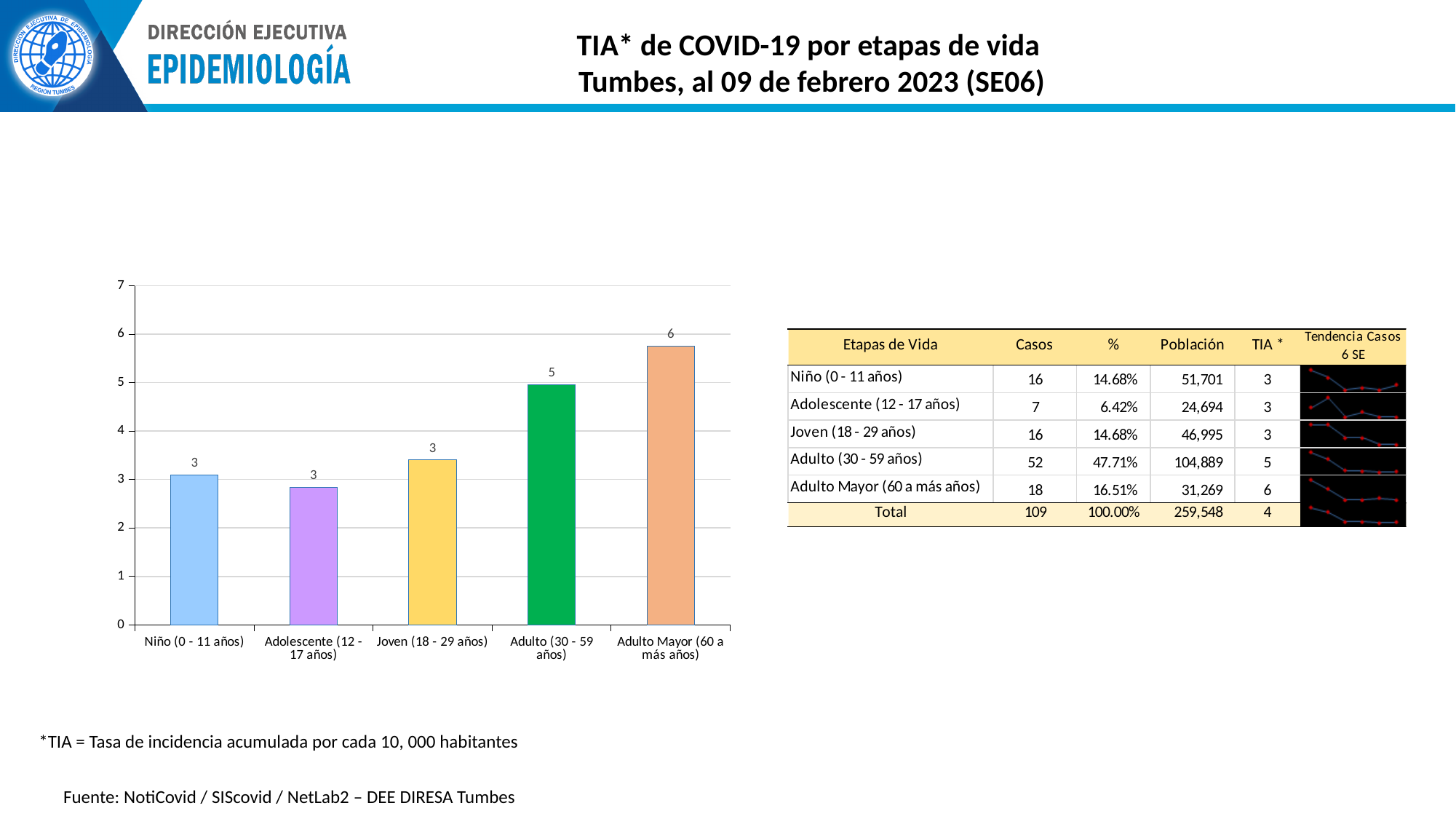
Which has a larger TIA in the bar chart, Adulto (30 - 59 años) or Joven (18 - 29 años)? Adulto (30 - 59 años) What kind of chart is used to show the TIA by life stage? bar chart What colour is the bar for Adulto (30 - 59 años)? green What is the TIA value shown for Niño (0 - 11 años) in the bar chart? 3 Do the TIA values generally rise or fall from Niño to Adulto Mayor along the x axis? rise Is the bar for Adulto Mayor (60 a más años) greater or less than 5? greater What is the difference between the TIA labels for Adulto Mayor (60 a más años) and Adulto (30 - 59 años)? 1 Is the bar for Niño (0 - 11 años) greater or less than 4? less Which life stage has the highest TIA in the bar chart? Adulto Mayor (60 a más años) What is the TIA value shown for Adulto Mayor (60 a más años) in the bar chart? 6 How many life-stage categories are shown in the bar chart? 5 What is the TIA value shown for Adulto (30 - 59 años) in the bar chart? 5